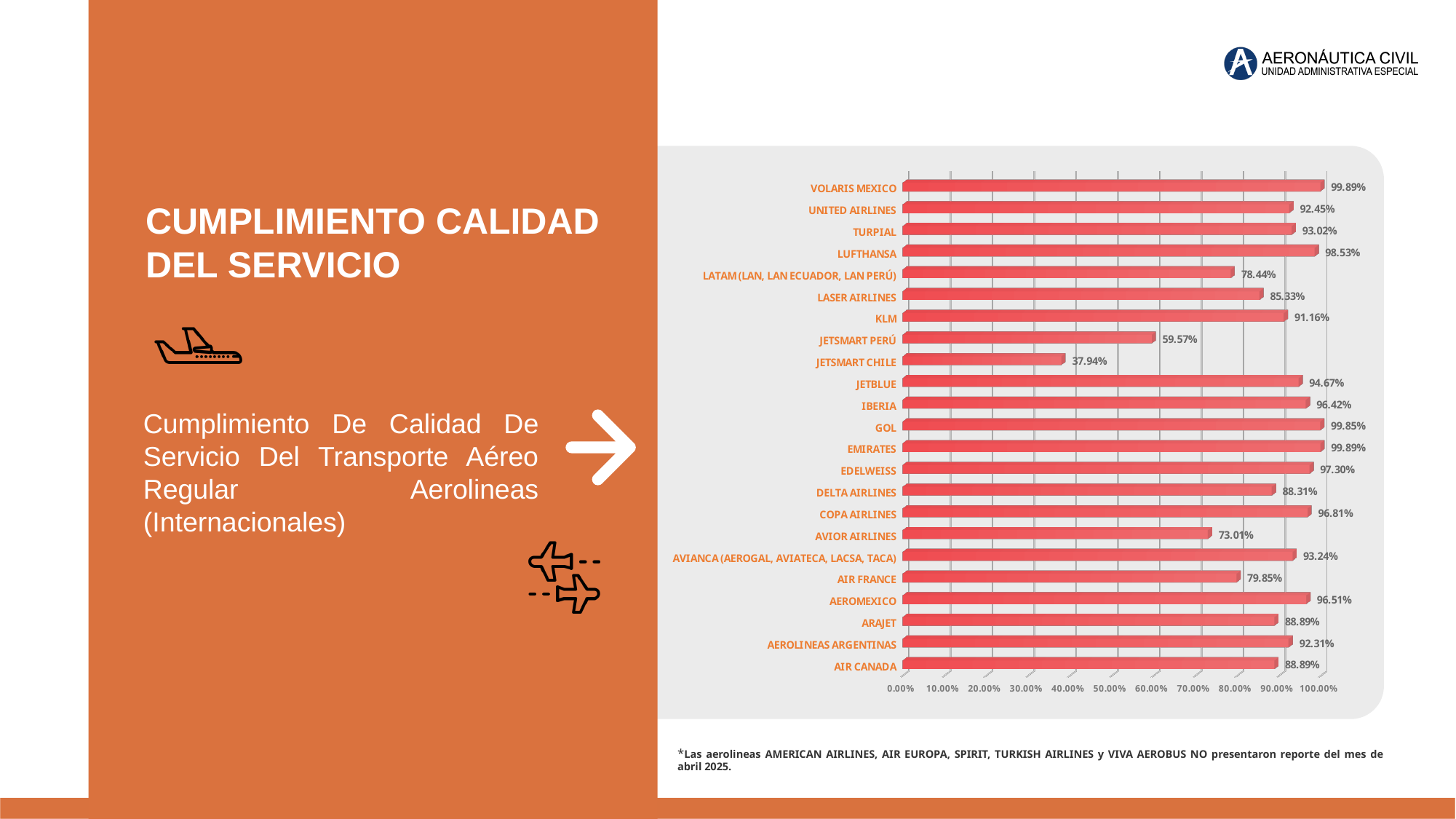
What is the value for JETSMART PERÚ? 59.57% What is the value for AEROLINEAS ARGENTINAS? 92.31% What is the value for LUFTHANSA? 98.53% What is the value for AVIOR AIRLINES? 73.01% What is the difference between the values for LUFTHANSA and LATAM (LAN, LAN ECUADOR, LAN PERÚ)? 20.09% Which is larger, the value for DELTA AIRLINES or the value for COPA AIRLINES? COPA AIRLINES What kind of chart is shown on the slide? bar chart Is the value for AVIOR AIRLINES greater or less than 80.00%? less Which airline has the lowest value? JETSMART CHILE How many airlines are shown in the chart? 23 What is the difference between the values for JETSMART PERÚ and JETSMART CHILE? 21.63% Is the value for JETSMART PERÚ greater or less than 50.00%? greater